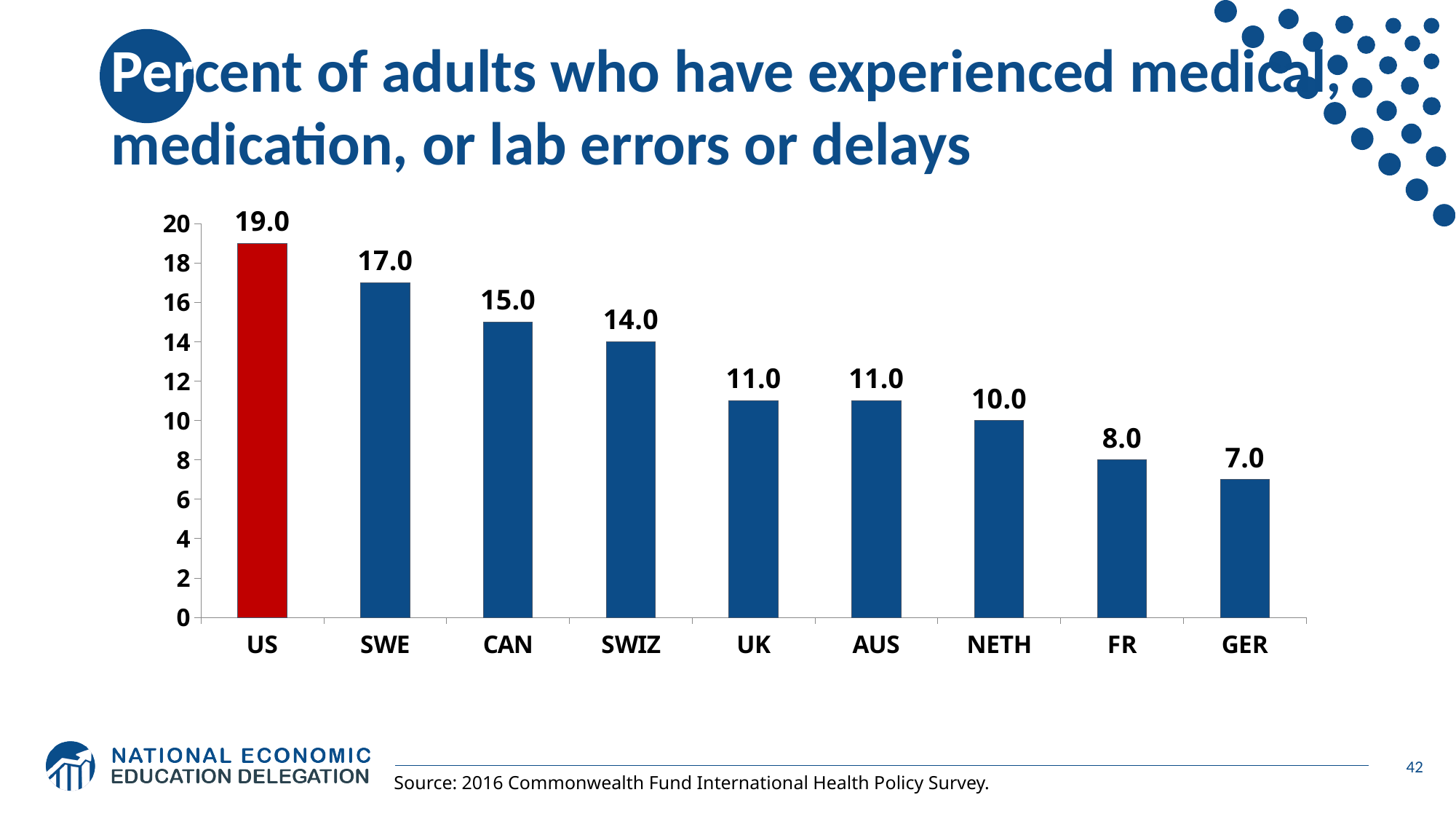
Which is larger, the value for FR or the value for NETH? NETH What is the value for the US? 19.0 Which country has the highest value? US Do the values rise or fall from left to right across the chart? fall What is the value for SWIZ? 14.0 What kind of chart is shown on the slide? bar chart What is the value for NETH? 10.0 What is the difference between the values for CAN and GER? 8.0 Which bar is coloured red rather than blue? US Which country has the lowest value? GER How many countries are shown on the chart? 9 What is the difference between the values for the US and SWE? 2.0